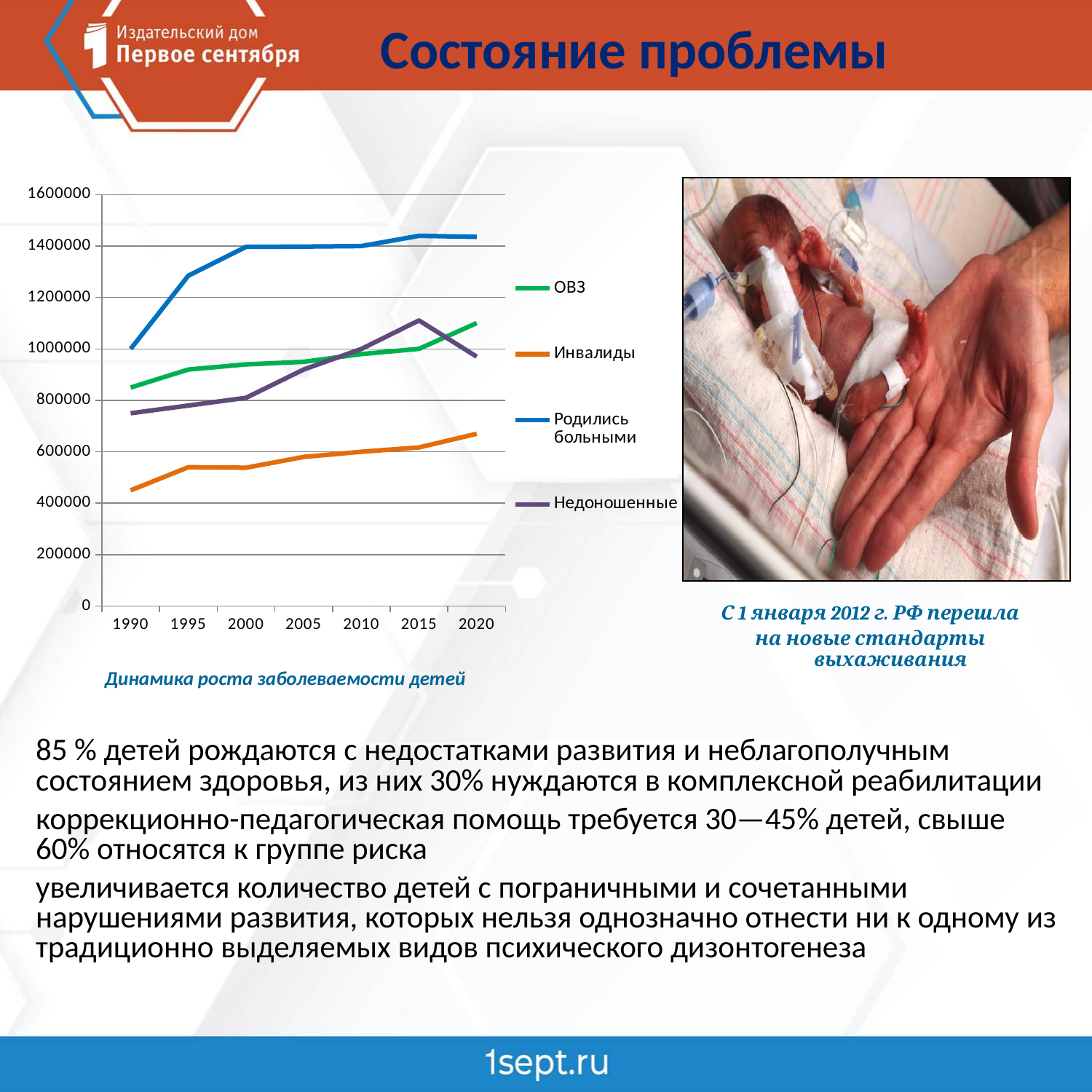
Is the value for ОВЗ in 1990 greater or less than 1000000? less How many years are marked on the x axis of the chart? 7 Is the value for Родились больными in 2020 greater or less than 1200000? greater Which series has the lowest value in 1990? Инвалиды How many series does the chart legend list? 4 Which series has the highest value in 2020? Родились больными Which series is drawn in orange in the chart? Инвалиды What is the caption written under the chart? Динамика роста заболеваемости детей In 2020, which is larger: the value for ОВЗ or the value for Недоношенные? ОВЗ Does the Инвалиды series rise or fall overall from 1990 to 2020? rise What kind of chart is shown on the slide? line chart Is the value for Инвалиды in 1990 greater or less than 600000? less